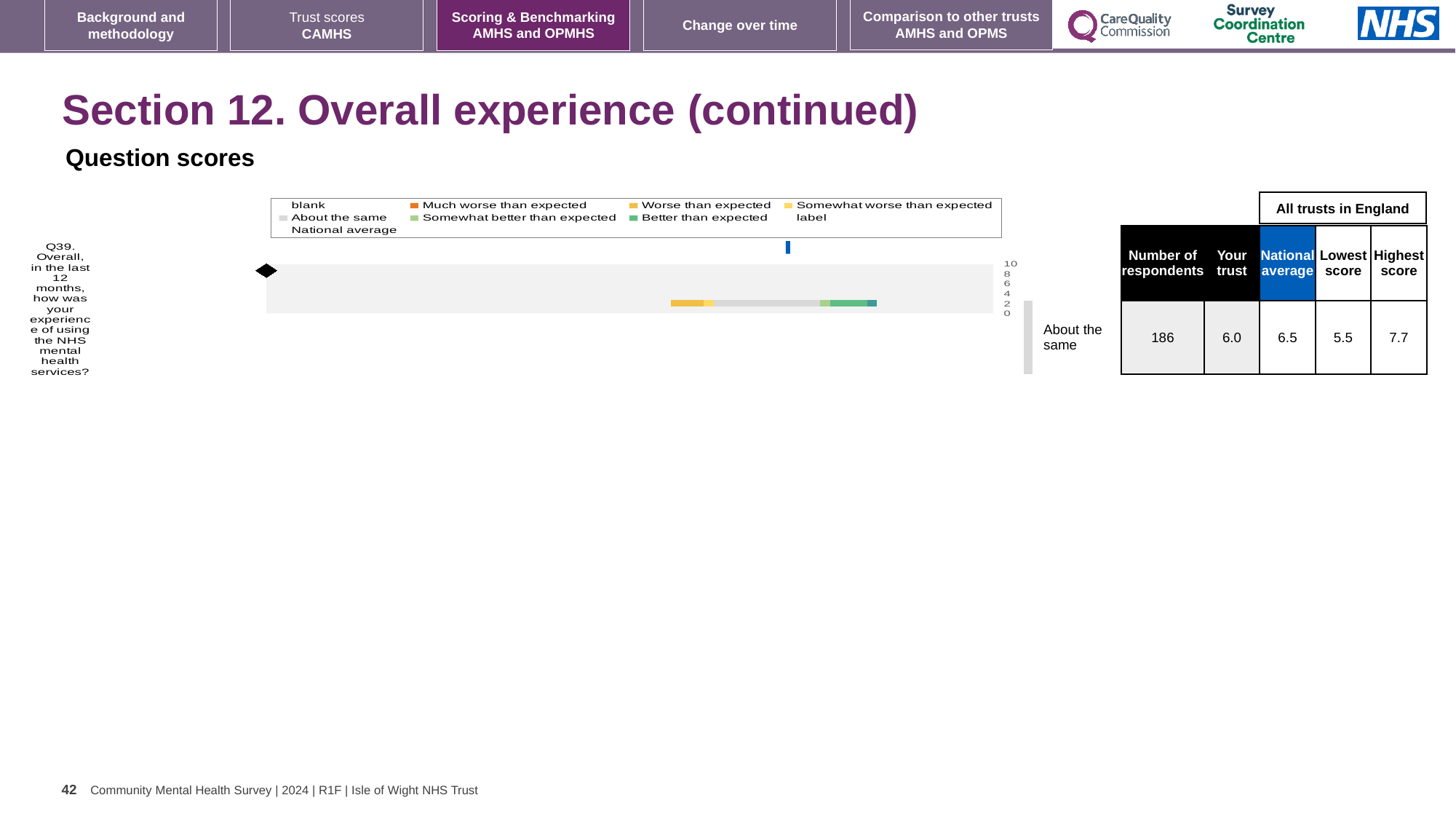
Is the 'Your trust' score for Q39 greater or less than 4 on the chart's axis? greater According to the table beside the chart, what is the 'Your trust' score for Q39? 6.0 How many survey questions are plotted in the chart? 1 For Q39, which is larger: the 'Your trust' score or the national average? National average What benchmark category label is shown to the right of the Q39 bar? About the same According to the table beside the chart, what is the highest score among all trusts in England for Q39? 7.7 How many respondents answered Q39, according to the table beside the chart? 186 What is the highest value shown on the chart's score axis? 10 What kind of chart is shown for Q39 on the slide? bar chart For Q39, what is the difference between the national average (6.5) and the 'Your trust' score (6.0)? 0.5 According to the table beside the chart, what is the lowest score among all trusts in England for Q39? 5.5 According to the table beside the chart, what is the national average score for Q39? 6.5